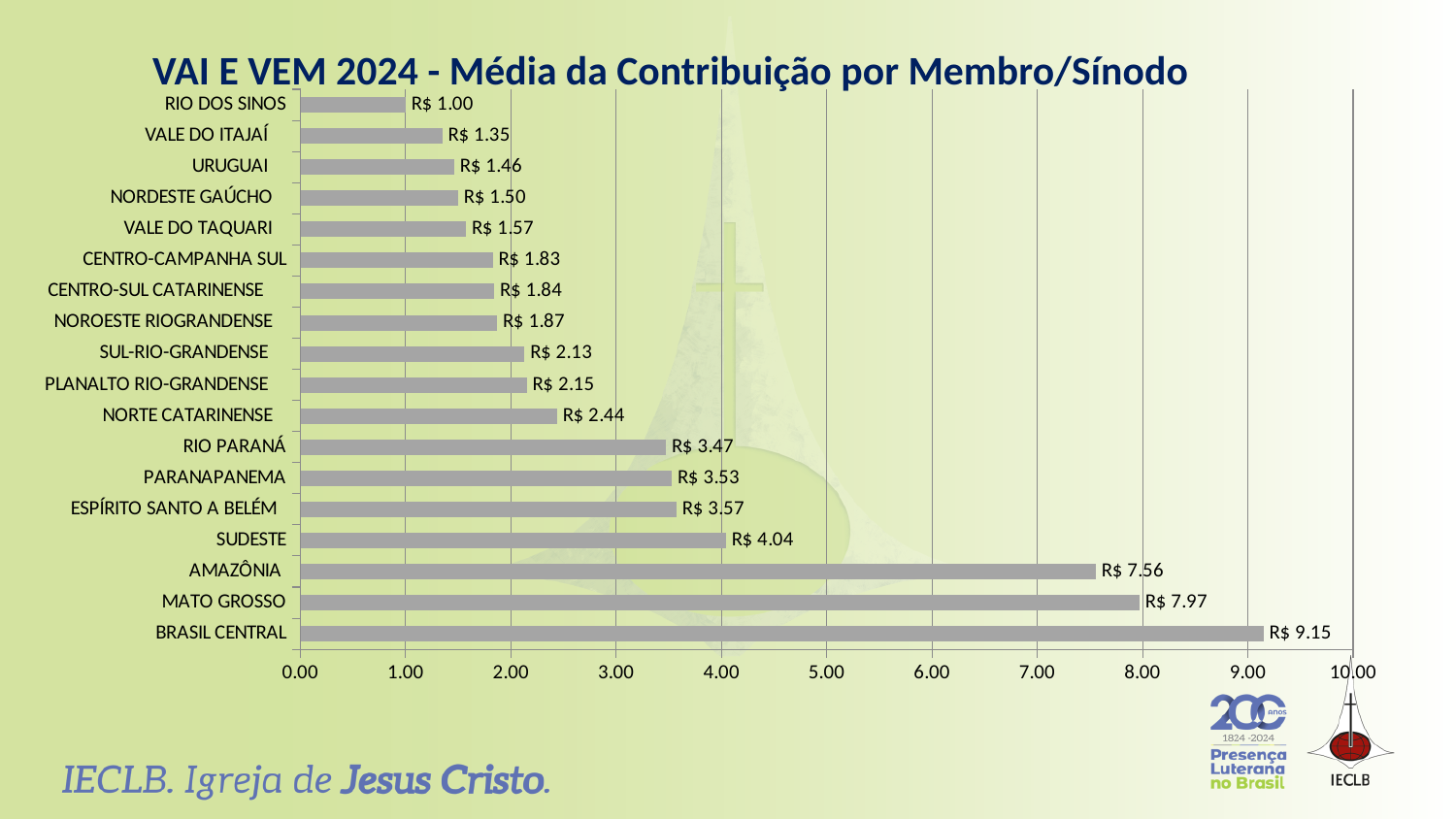
What is the difference between the values for BRASIL CENTRAL and RIO DOS SINOS? R$ 8.15 What is the difference between the values for MATO GROSSO and AMAZÔNIA? R$ 0.41 What kind of chart is shown on the slide? bar chart Which category has the highest value? BRASIL CENTRAL Which is larger, the value for RIO PARANÁ or the value for SUDESTE? SUDESTE What is the value for SUDESTE? R$ 4.04 Which category has the lowest value? RIO DOS SINOS What is the title of the chart? VAI E VEM 2024 - Média da Contribuição por Membro/Sínodo What is the value for NORTE CATARINENSE? R$ 2.44 Is the value for AMAZÔNIA greater or less than 7.00? greater What is the value for BRASIL CENTRAL? R$ 9.15 How many categories are shown in the chart? 18